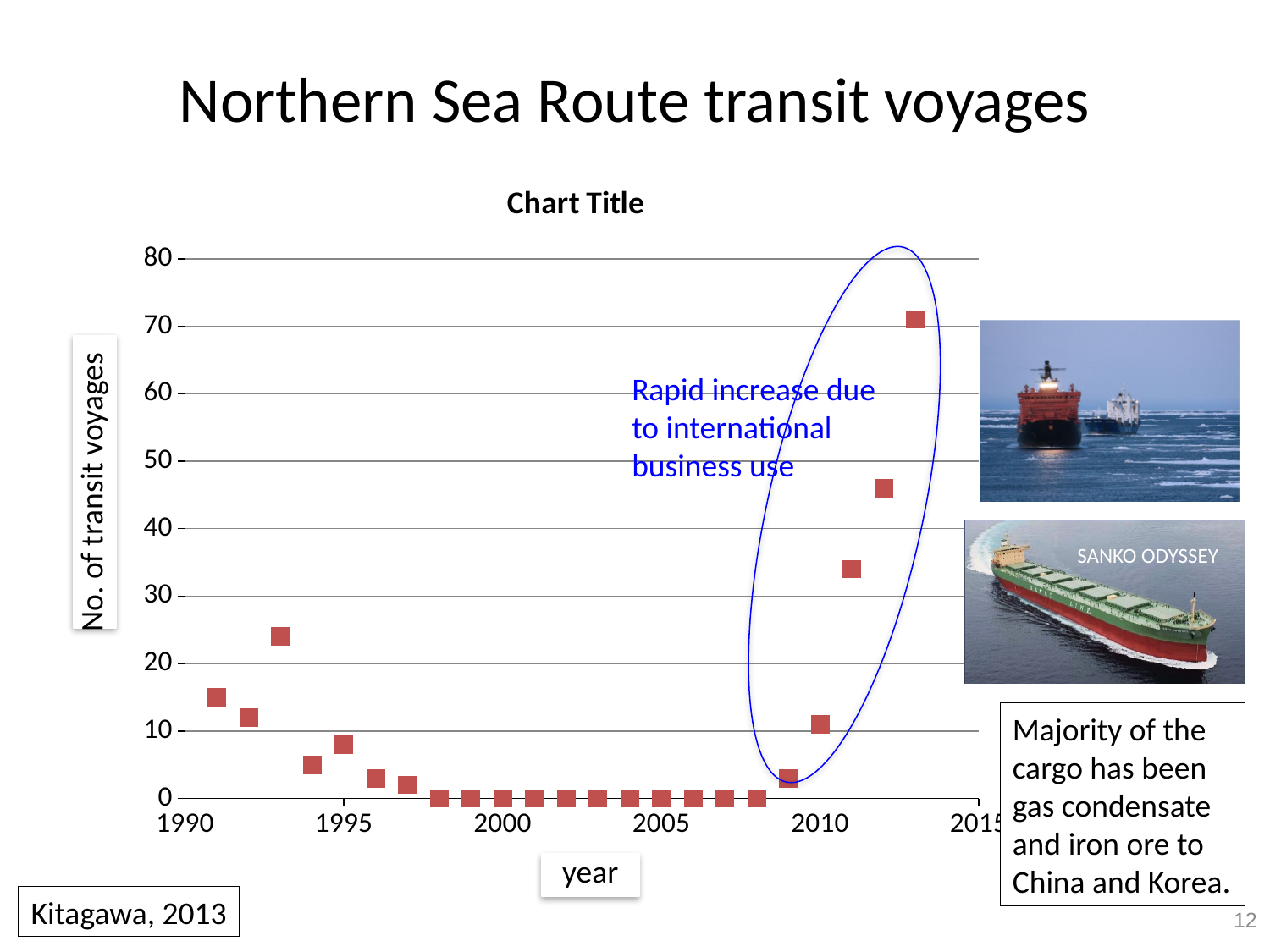
Is the value for 1993 greater or less than 20? greater What is the number of transit voyages in 2000? 0 What is the label on the vertical axis of the chart? No. of transit voyages Is the value for 2012 greater or less than 40? greater Which year has more transit voyages, 2012 or 2013? 2013 What is the number of transit voyages in 2005? 0 Is the value for 2013 greater or less than 60? greater Do the values rise or fall from 2009 to 2013? rise What kind of chart is shown on the slide? scatter chart What is the label on the horizontal axis of the chart? year Which year has the highest number of transit voyages? 2013